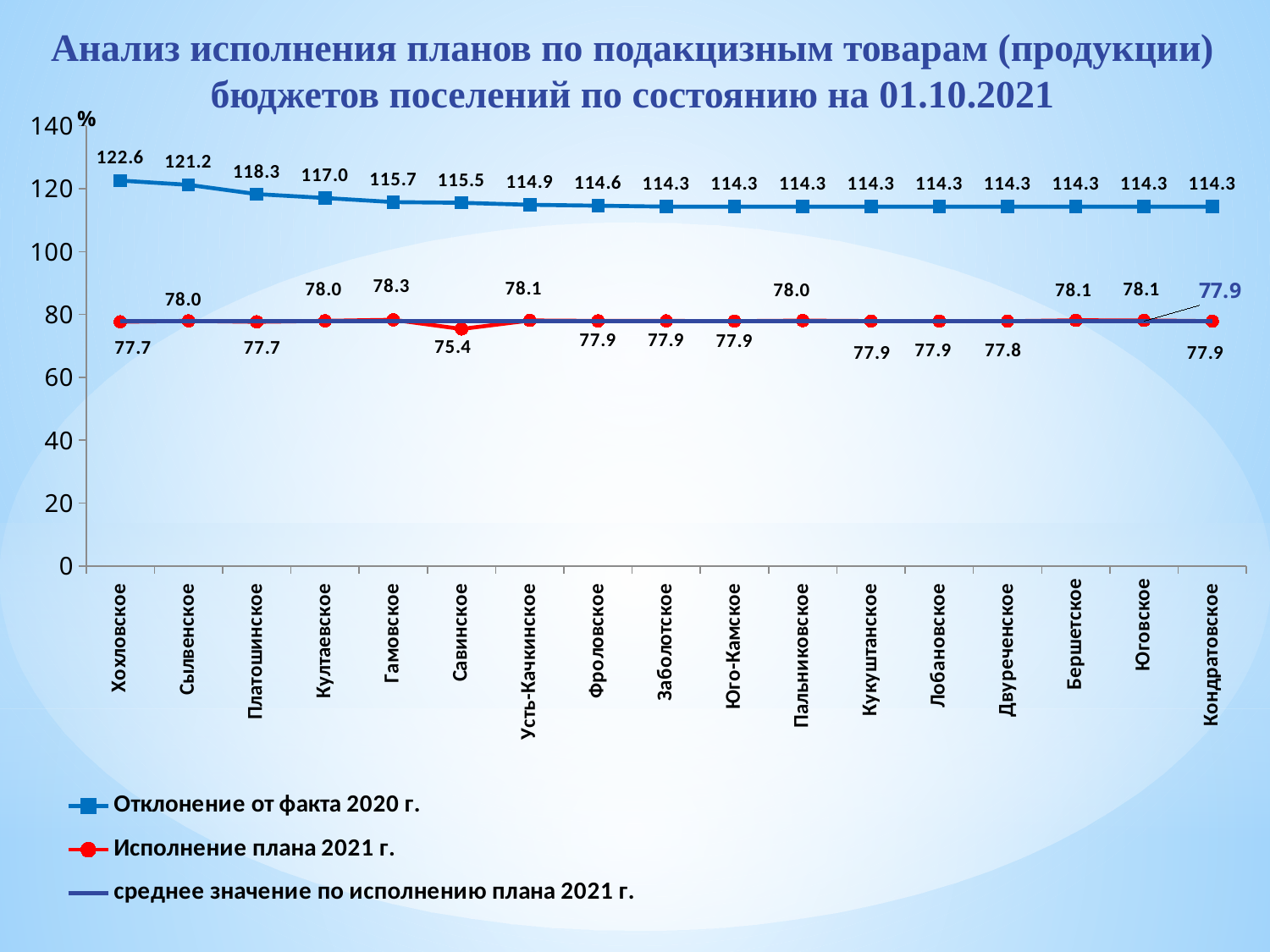
What is the value of "Исполнение плана 2021 г." for Гамовское? 78.3 What is the value of "Отклонение от факта 2020 г." for Хохловское? 122.6 What is the value of "Исполнение плана 2021 г." for Савинское? 75.4 How many series does the legend list? 3 Which settlement has the lowest value for "Исполнение плана 2021 г."? Савинское What kind of chart is shown on the slide? line chart Does the "Отклонение от факта 2020 г." series rise or fall from Хохловское to Кондратовское? fall Is the value of "Исполнение плана 2021 г." for Усть-Качкинское greater or less than 100? less Which is larger: the "Отклонение от факта 2020 г." value for Сылвенское or for Платошинское? Сылвенское What is the difference between the "Отклонение от факта 2020 г." values for Хохловское and Кондратовское? 8.3 How many settlements are shown on the x axis? 17 Which settlement has the highest value for "Отклонение от факта 2020 г."? Хохловское